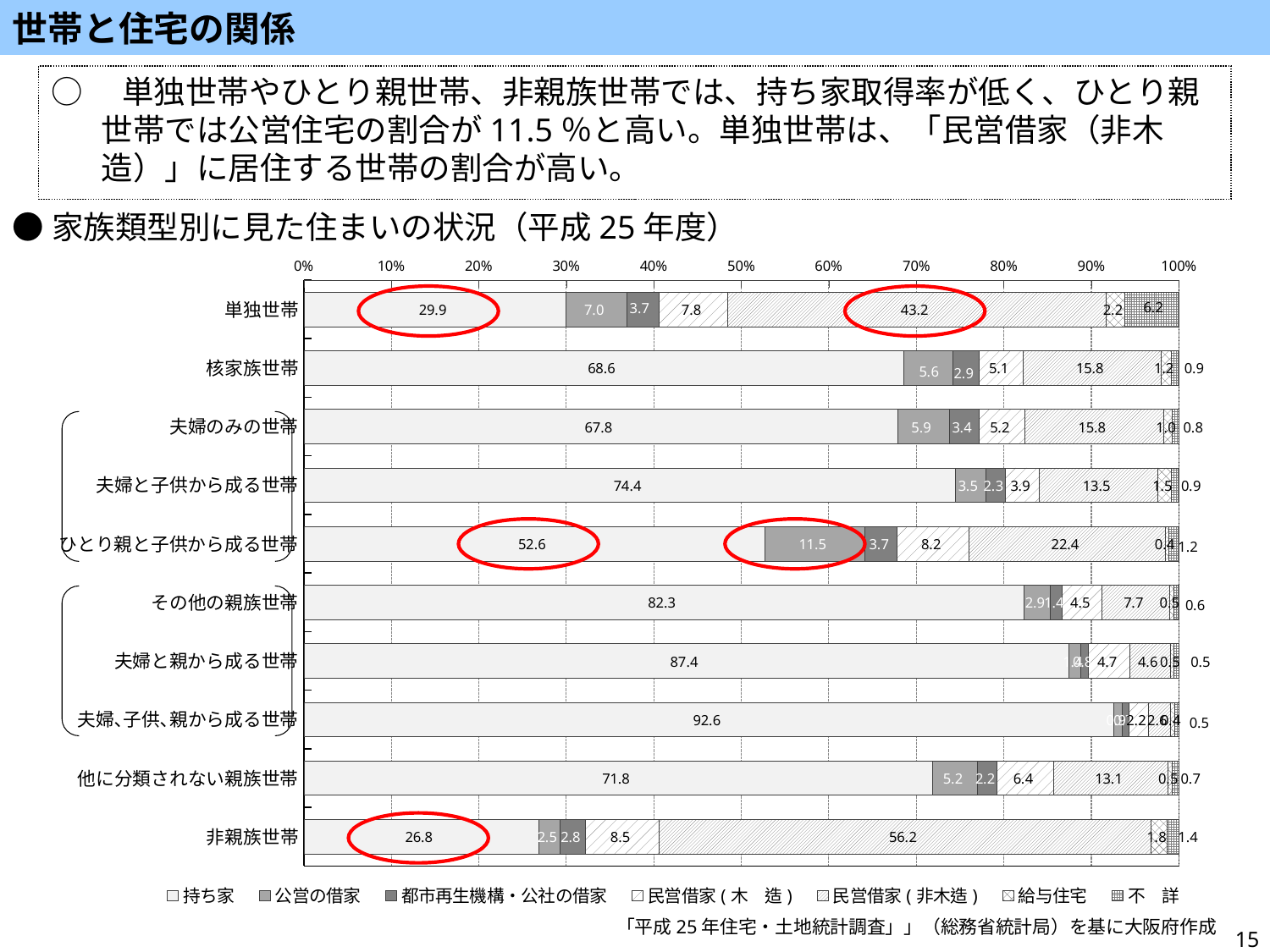
Which is larger, the 民営借家(非木造) value for 単独世帯 or for ひとり親と子供から成る世帯? 単独世帯 What is the 民営借家(非木造) value for 非親族世帯? 56.2 Is the 持ち家 value for 核家族世帯 greater or less than 60%? greater How many household types (categories) are plotted on the chart? 10 What kind of chart is shown on the slide? Stacked bar chart What is the first series listed in the legend? 持ち家 Which household type has the lowest 持ち家 value? 非親族世帯 How many series does the legend list? 7 What is the difference between the 持ち家 values for 単独世帯 and 非親族世帯? 3.1 What is the 公営の借家 value for ひとり親と子供から成る世帯? 11.5 Which household type has the highest 持ち家 value? 夫婦、子供、親から成る世帯 What is the 持ち家 value for 単独世帯? 29.9